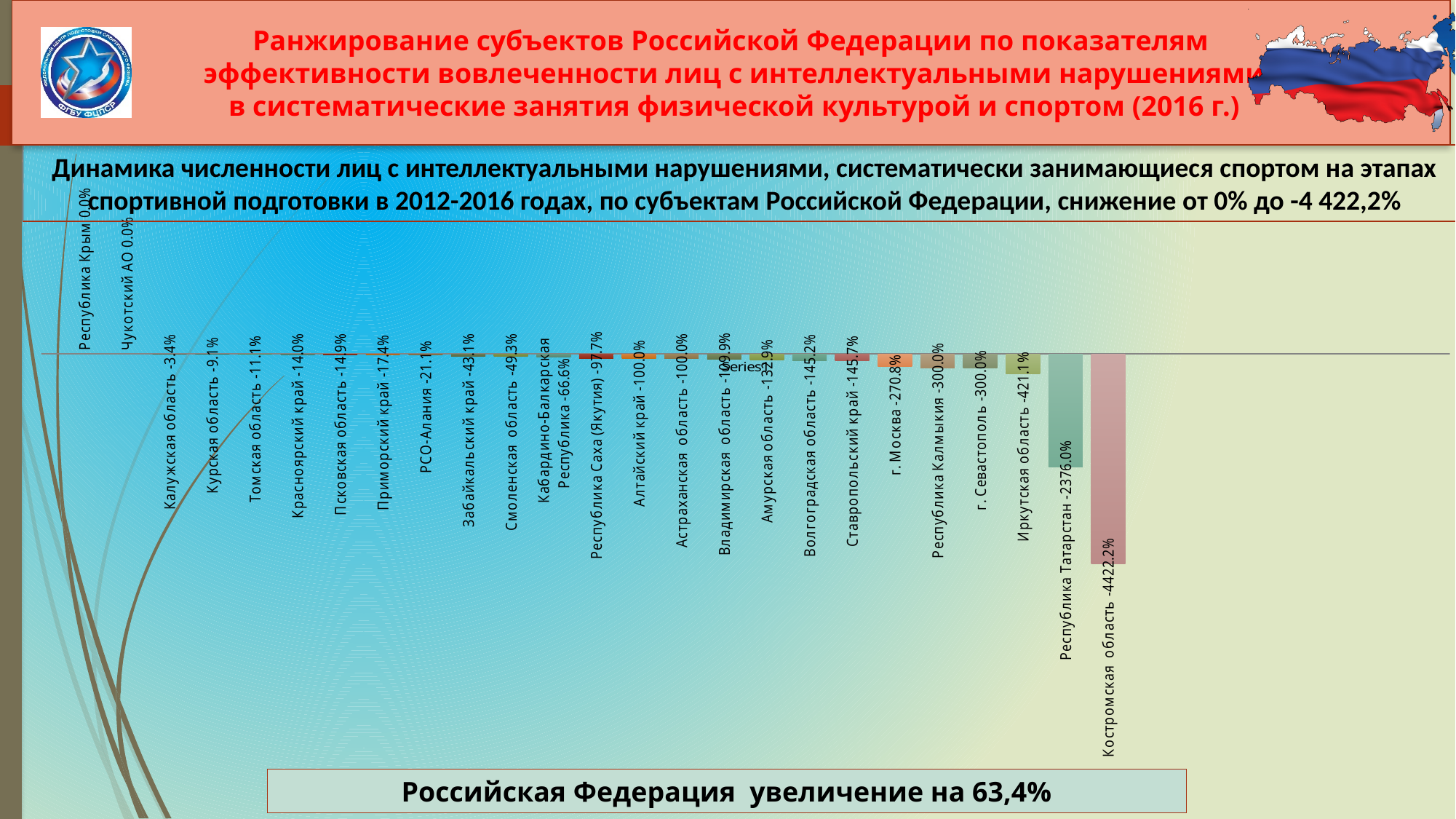
What is the difference between the values for Костромская область and Республика Татарстан? 2046.2 percentage points What is the value shown for г. Москва? -270.8% How many subjects (categories) are plotted in the chart? 25 What is the value shown for Калужская область? -3.4% What is the value shown for Республика Татарстан? -2376.0% What type of chart is shown on the slide? bar chart What is the value shown for Иркутская область? -421.1% Which subject has the lowest (most negative) value in the chart? Костромская область According to the text box at the bottom of the slide, by how much did the figure for the Российская Федерация increase? 63,4% What is the value shown for Костромская область? -4422.2% Which has the larger decline, Республика Калмыкия or г. Москва? Республика Калмыкия Do the values rise or fall moving from left to right along the x axis? fall